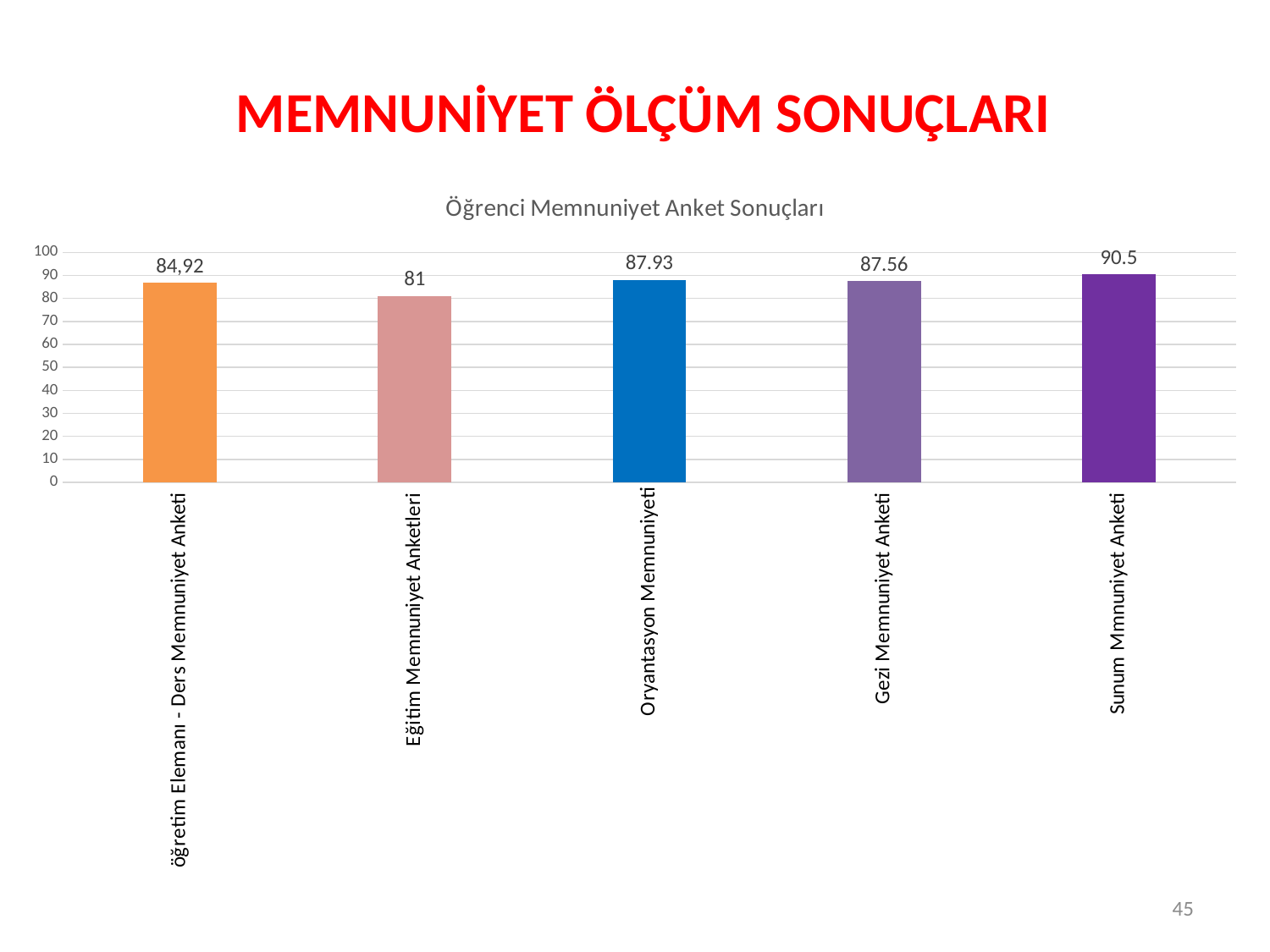
Which is larger, the value for Oryantasyon Memnuniyeti or the value for Gezi Memnuniyet Anketi? Oryantasyon Memnuniyeti What type of chart is shown on the slide? bar chart Is the value for Eğitim Memnuniyet Anketleri greater or less than 90? less What is the value for Sunum Mmnuniyet Anketi? 90.5 Which category has the lowest value? Eğitim Memnuniyet Anketleri What is the value for Oryantasyon Memnuniyeti? 87.93 What is the value for Gezi Memnuniyet Anketi? 87.56 What is the difference between the values for Sunum Mmnuniyet Anketi and Eğitim Memnuniyet Anketleri? 9.5 What is the value for öğretim Elemanı - Ders Memnuniyet Anketi? 84,92 What is the value for Eğitim Memnuniyet Anketleri? 81 How many categories are shown in the chart? 5 Which category has the highest value? Sunum Mmnuniyet Anketi